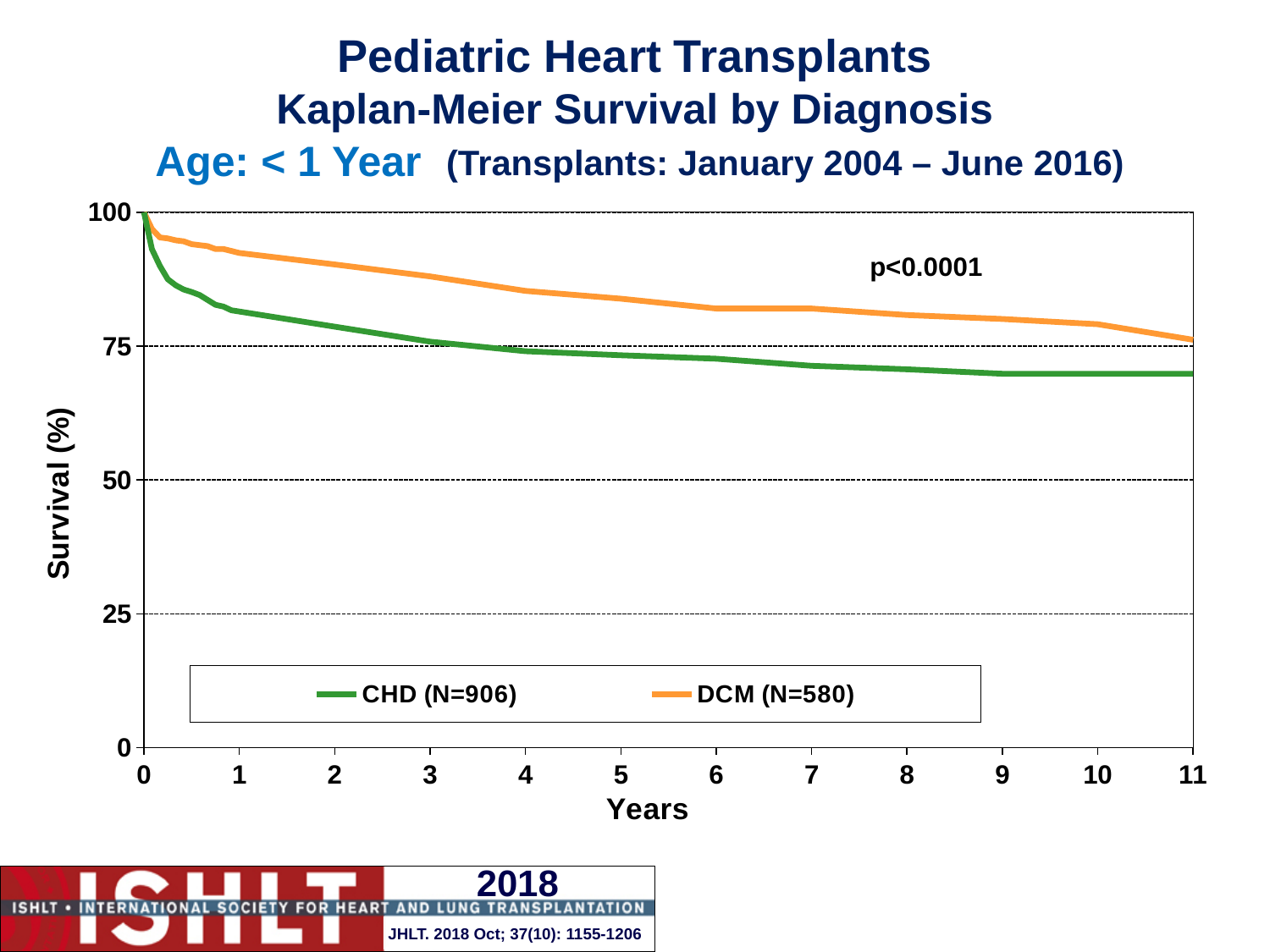
Which series has higher survival at 5 years, CHD or DCM? DCM Do the survival curves rise or fall as years increase? fall How many series does the legend list? 2 What is the maximum value shown on the x axis? 11 Is the survival for DCM at 10 years greater or less than 75? greater What is the label of the y axis? Survival (%) Is the survival for CHD at 1 year greater or less than 75? greater What p-value is printed on the chart? p<0.0001 Is the survival for DCM at 2 years greater or less than 100? less What is the N for the CHD series in the legend? 906 What kind of chart is shown on the slide? line chart